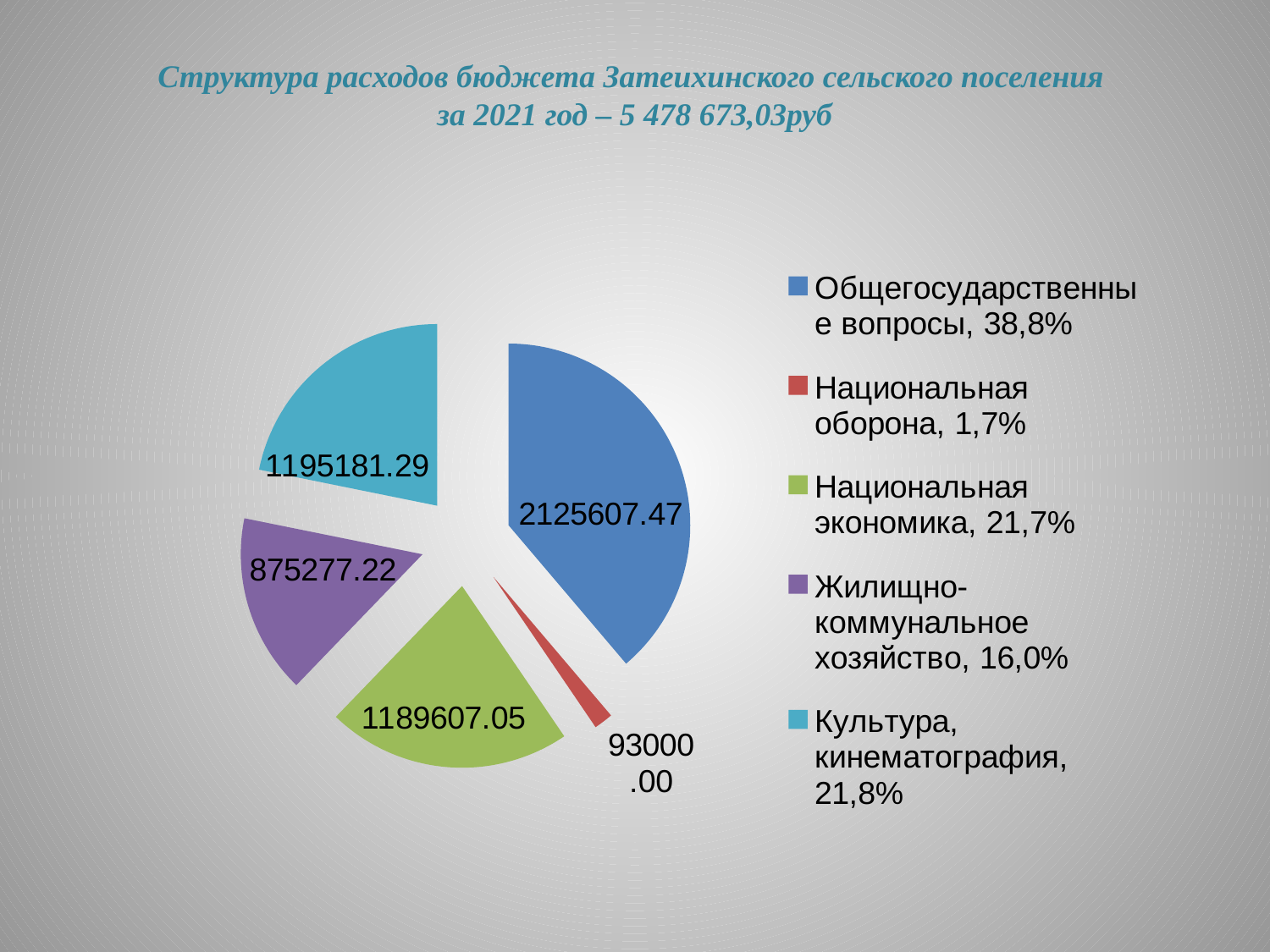
What is the value shown for Национальная оборона? 93000.00 Which is larger: the value for Жилищно-коммунальное хозяйство or the value for Культура, кинематография? Культура, кинематография Which category has the largest slice of the pie? Общегосударственные вопросы Which category has the smallest slice of the pie? Национальная оборона What total budget expenditure amount is stated in the chart title for 2021? 5 478 673,03руб What is the value shown for Жилищно-коммунальное хозяйство? 875277.22 What type of chart is shown on the slide? pie chart What share of the pie does Национальная экономика represent, according to the legend? 21,7% What is the value shown for Общегосударственные вопросы? 2125607.47 How many slices does the pie chart have? 5 What is the difference between the values for Общегосударственные вопросы and Жилищно-коммунальное хозяйство? 1250330.25 What is the value shown for Культура, кинематография? 1195181.29